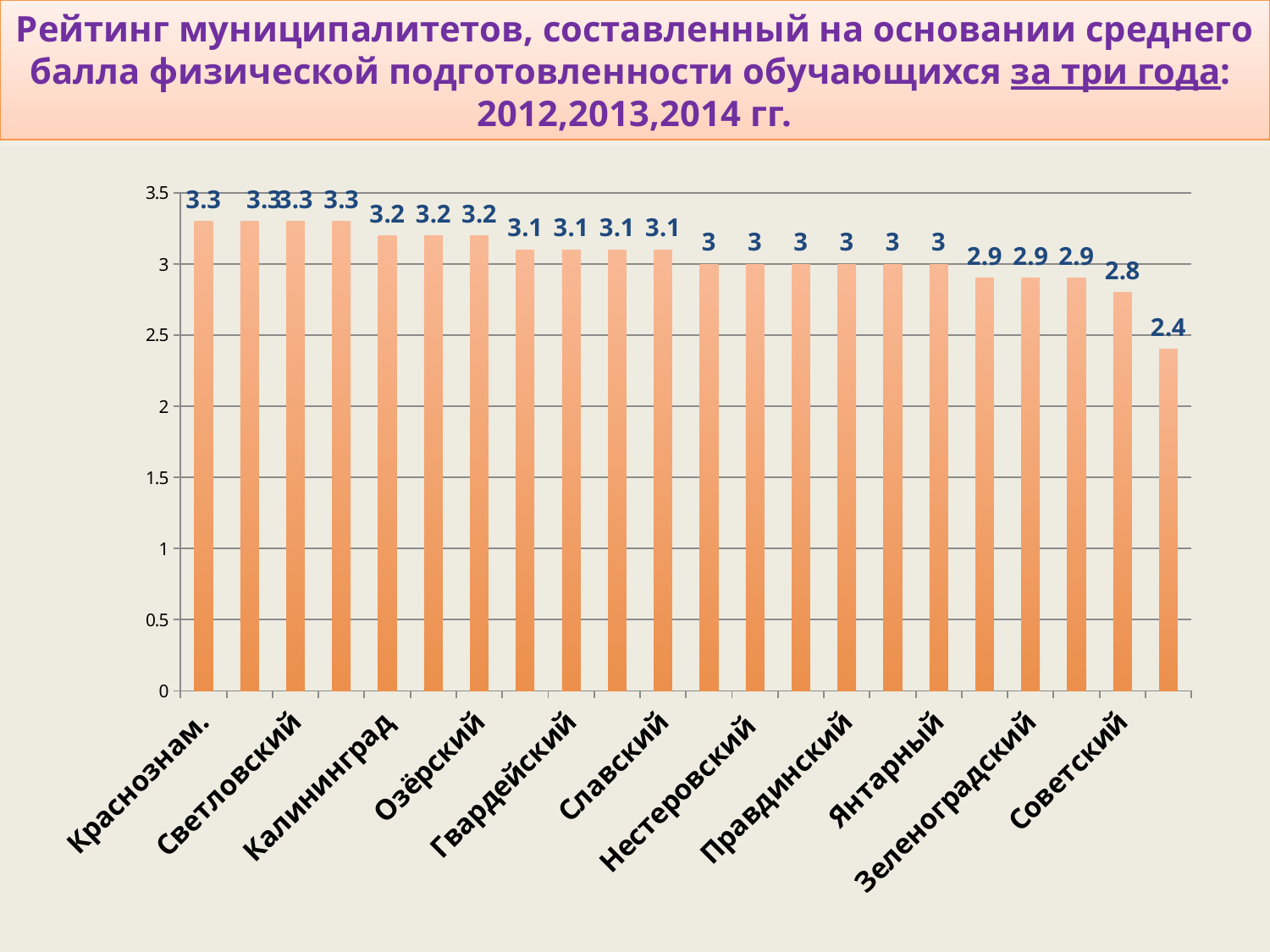
What kind of chart is shown on the slide? bar chart What is the value for Зеленоградский? 2.9 What is the difference between the values for Краснознам. and Советский? 0.5 What is the value for Озёрский? 3.2 What is the value for Краснознам.? 3.3 What is the value for Советский? 2.8 How many bars are plotted in the chart? 22 Is the value for Советский greater or less than 3? less Which three years does the chart title say the rating covers? 2012, 2013, 2014 Which has the larger value, Калининград or Гвардейский? Калининград What is the value for Нестеровский? 3 Do the values rise or fall from left to right along the x axis? fall